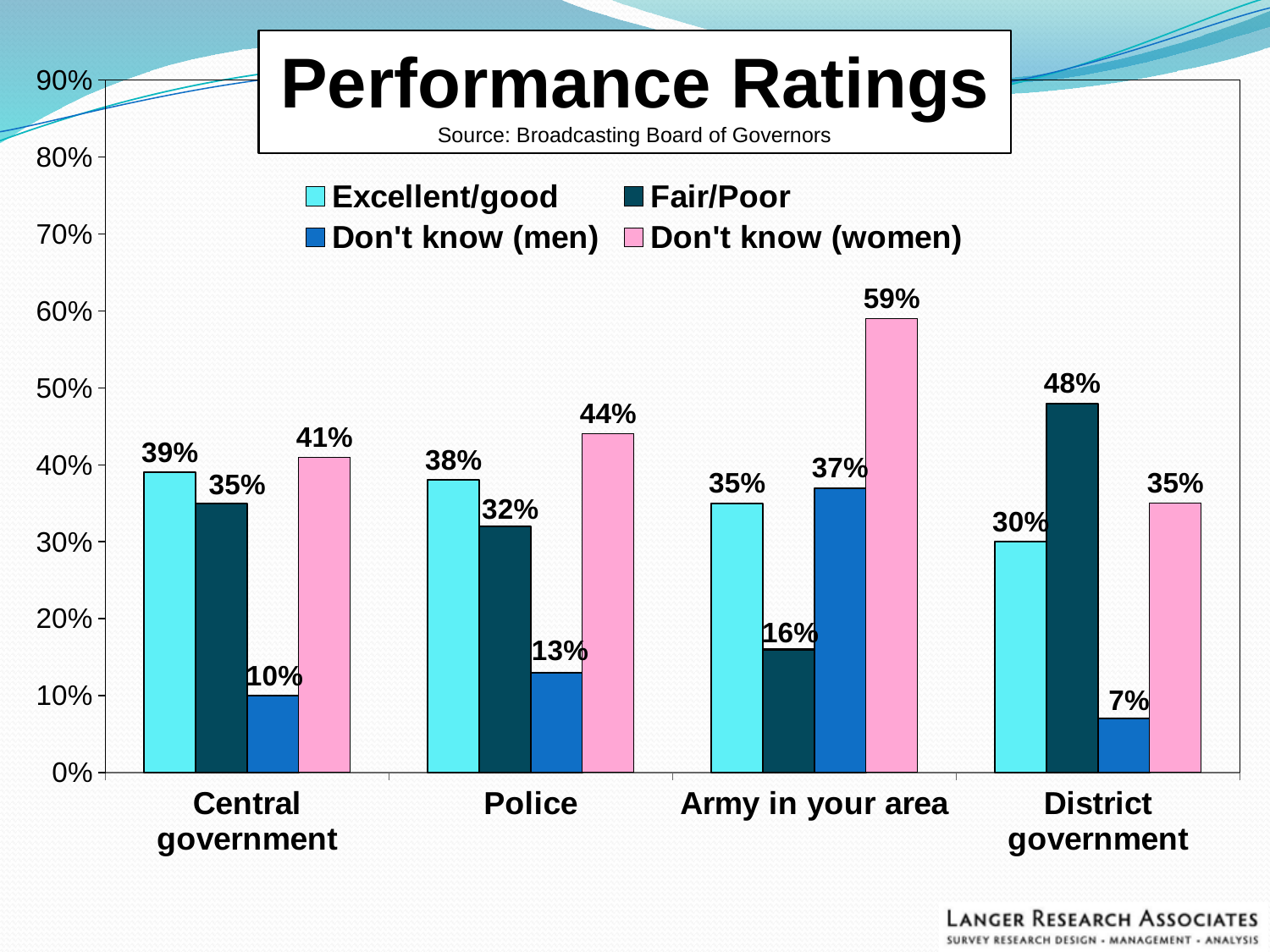
How many categories are shown on the x axis? 4 What is the difference between the Don't know (women) and Don't know (men) values for Army in your area? 22% What is the Excellent/good rating for Central government? 39% How many series does the legend list? 4 What is the Don't know (men) value for Police? 13% Which category has the highest Don't know (women) value? Army in your area For District government, which is larger: the Excellent/good rating or the Fair/Poor rating? Fair/Poor Which category has the lowest Don't know (men) value? District government What is the source cited under the chart title? Broadcasting Board of Governors What is the Don't know (women) value for Army in your area? 59% What kind of chart is shown on the slide? Bar chart What is the Fair/Poor rating for District government? 48%